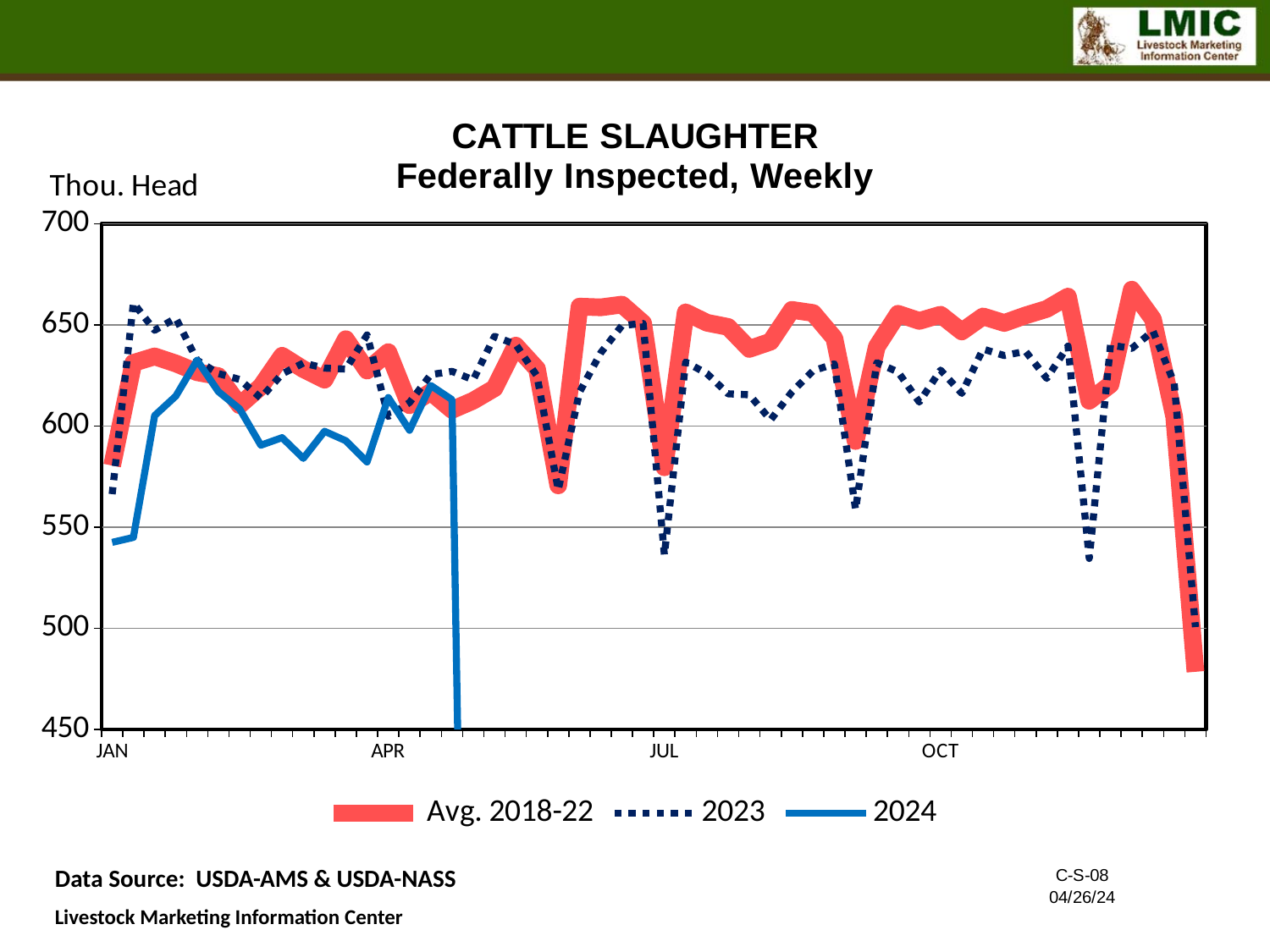
Is the peak of the Avg. 2018-22 series in December greater or less than 650? greater What unit is shown on the y axis of the chart? Thou. Head Is the final value of the Avg. 2018-22 series at the end of the year greater or less than 500? less Is the lowest value of the 2023 series, in the dip near the end of the year, greater or less than 550? less What kind of chart is shown on the slide? line chart What is the title of the chart? CATTLE SLAUGHTER Federally Inspected, Weekly Does the Avg. 2018-22 series rise or fall over the last few weeks of the year? fall How many month labels are shown on the x axis? 4 How many series does the legend list? 3 At the start of January, which series is higher: Avg. 2018-22 or 2024? Avg. 2018-22